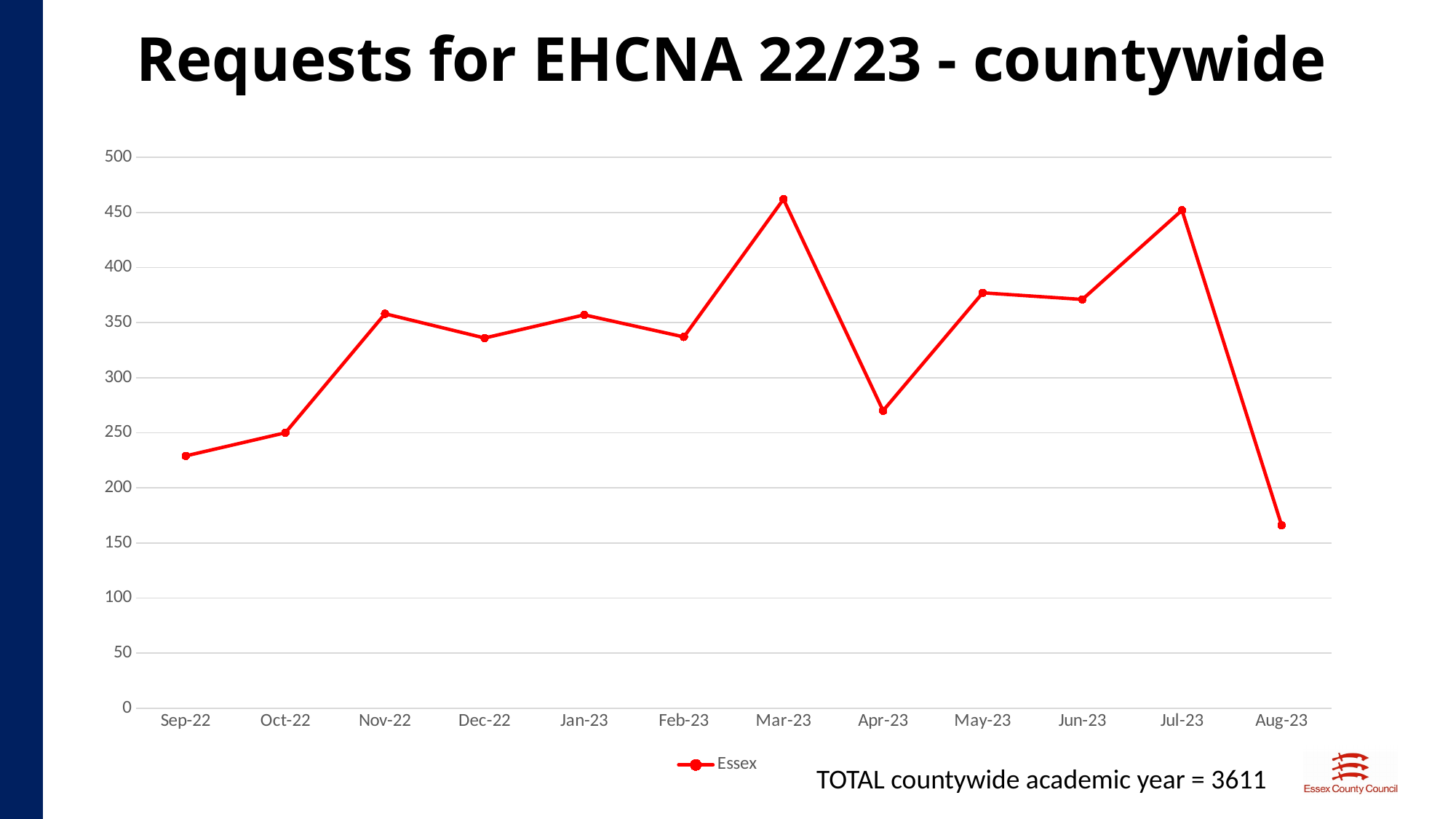
Do the values rise or fall from Sep-22 to Nov-22? rise Which month has the highest number of requests? Mar-23 Is the value for Sep-22 greater or less than 200? greater How many months are plotted on the x axis? 12 Which month has the lowest number of requests? Aug-23 Is the value for Aug-23 greater or less than 200? less How many series does the legend list? 1 Is the value for Apr-23 greater or less than 300? less Which is larger, the value for Jul-23 or the value for Jun-23? Jul-23 What is the name of the series shown in the legend? Essex What kind of chart is shown on the slide? line chart